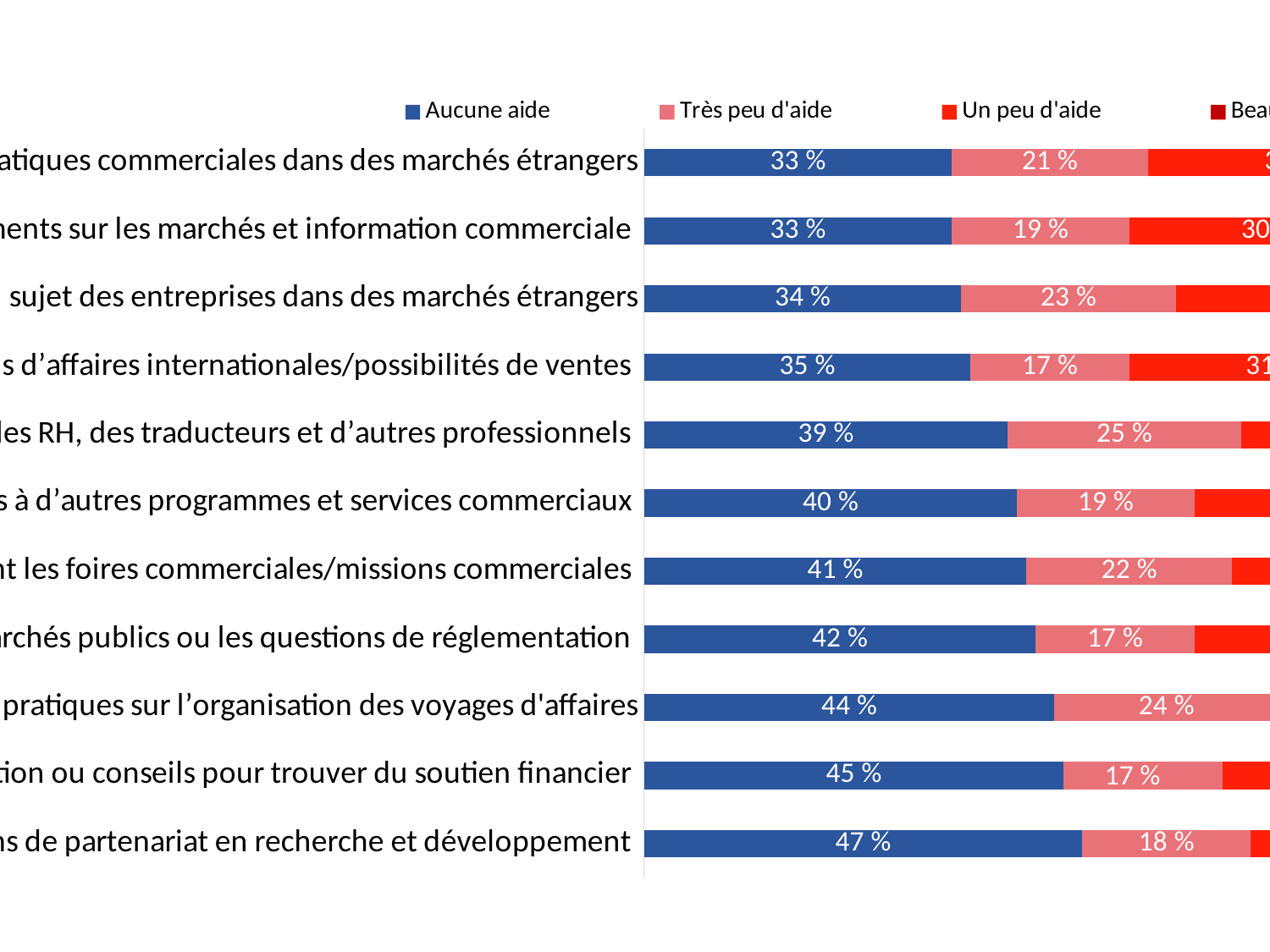
What is the 'Aucune aide' value for the category ending in 'organisation des voyages d'affaires'? 44 % What is the 'Très peu d'aide' value for the category ending in 'conseils pour trouver du soutien financier'? 17 % What colour represents the 'Aucune aide' series in the chart? blue How many category bars are plotted in the chart? 11 What is the difference in 'Aucune aide' between the bottom bar (47 %) and the top bar (33 %)? 14 % What is the lowest 'Aucune aide' value shown in the chart? 33 % What is the 'Aucune aide' value for the bottom bar (the category ending in 'partenariat en recherche et développement')? 47 % Which category has the highest 'Très peu d'aide' value? the category ending in 'des RH, des traducteurs et d'autres professionnels' (25 %) Which has the larger 'Très peu d'aide' value: the category ending in 'foires commerciales/missions commerciales' or the one ending in 'programmes et services commerciaux'? foires commerciales/missions commerciales (22 %) Which category has the highest 'Aucune aide' value? the bottom bar, ending in 'partenariat en recherche et développement' (47 %) Do the 'Aucune aide' values rise or fall going from the top bar to the bottom bar? rise What kind of chart is shown on the slide? bar chart